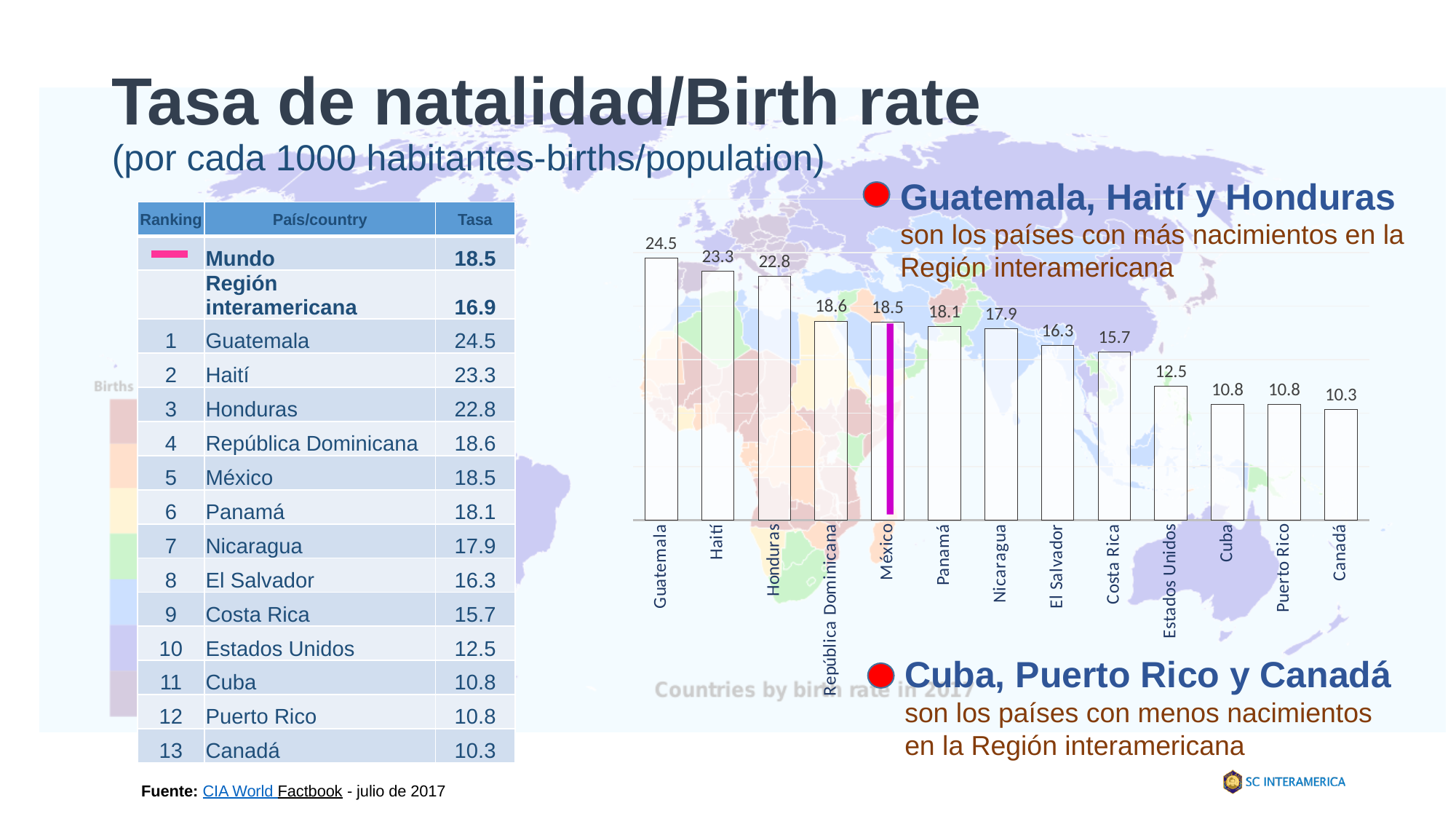
What is the difference between the birth rates of Honduras and Panamá in the bar chart? 4.7 What is the difference between the birth rates of Guatemala and Canadá in the bar chart? 14.2 What is the birth rate value shown for Costa Rica in the bar chart? 15.7 How many countries are shown in the bar chart? 13 What is the birth rate value shown for Guatemala in the bar chart? 24.5 Which has a higher birth rate in the bar chart, El Salvador or Estados Unidos? El Salvador Which has a higher birth rate in the bar chart, Haití or Nicaragua? Haití Do the birth rate values rise or fall from left to right across the bar chart? Fall What is the birth rate value shown for Estados Unidos in the bar chart? 12.5 What type of chart is used to show the birth rates? Bar chart Which country has the highest birth rate in the bar chart? Guatemala Which country has the lowest birth rate in the bar chart? Canadá